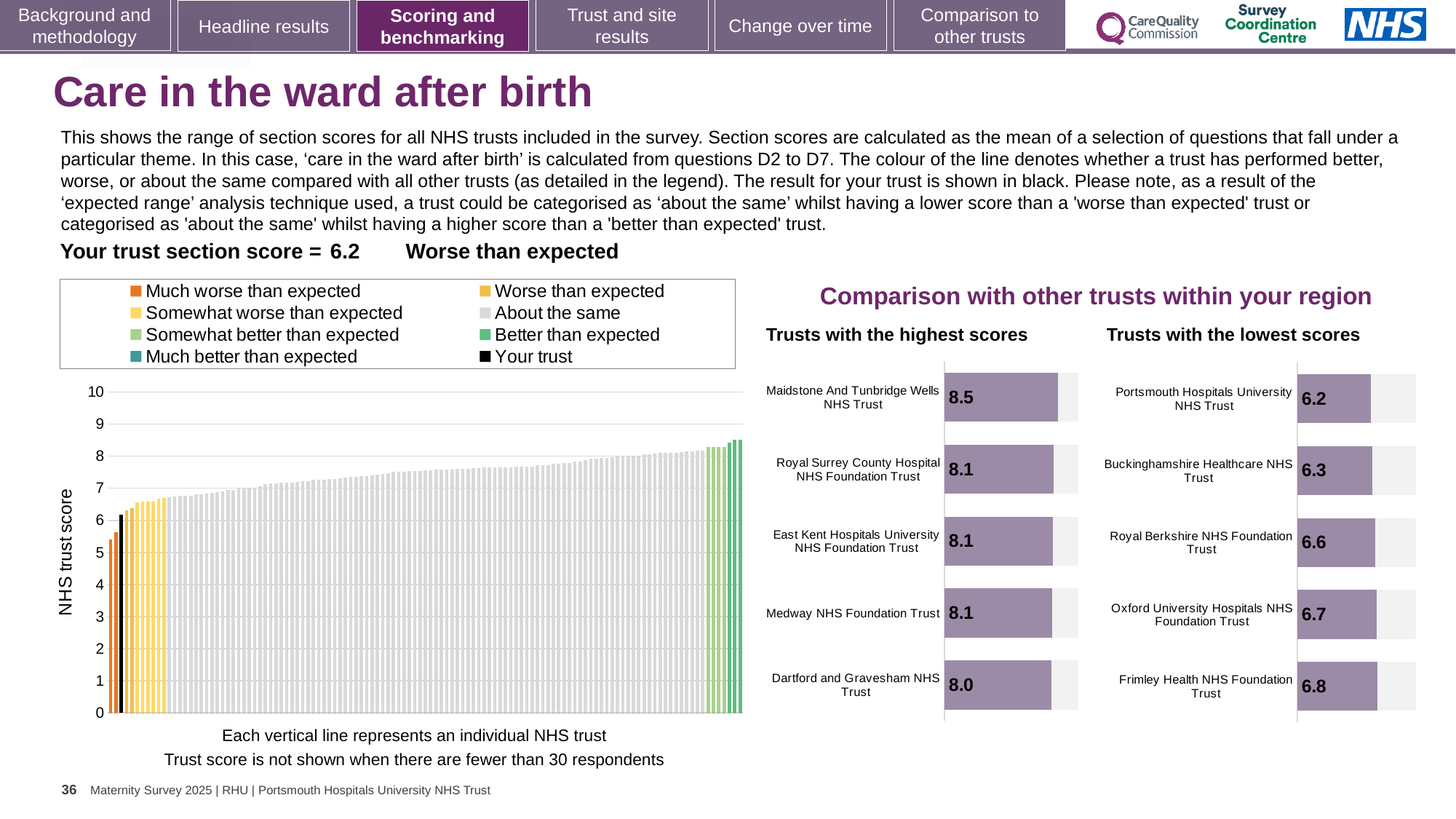
In the 'Trusts with the highest scores' chart, what is the difference between the scores of Maidstone And Tunbridge Wells NHS Trust and Dartford and Gravesham NHS Trust? 0.5 In the 'Trusts with the highest scores' chart, which trust has the lowest score? Dartford and Gravesham NHS Trust How many entries does the legend of the NHS trust score chart on the left list? 8 What kind of chart is the NHS trust score chart on the left of the slide? Bar chart How many trusts are shown in the 'Trusts with the highest scores' chart? 5 In the 'Trusts with the lowest scores' chart, what is the difference between the scores of Frimley Health NHS Foundation Trust and Portsmouth Hospitals University NHS Trust? 0.6 In the 'Trusts with the lowest scores' chart, what is the score for Royal Berkshire NHS Foundation Trust? 6.6 In the 'Trusts with the lowest scores' chart, which has the higher score: Royal Berkshire NHS Foundation Trust or Oxford University Hospitals NHS Foundation Trust? Oxford University Hospitals NHS Foundation Trust What is the y-axis label of the chart on the left of the slide? NHS trust score In the 'Trusts with the highest scores' chart, what is the score for Maidstone And Tunbridge Wells NHS Trust? 8.5 In the 'Trusts with the lowest scores' chart, which trust has the highest score? Frimley Health NHS Foundation Trust In the NHS trust score chart on the left, is the value of the lowest bar greater or less than 6? less